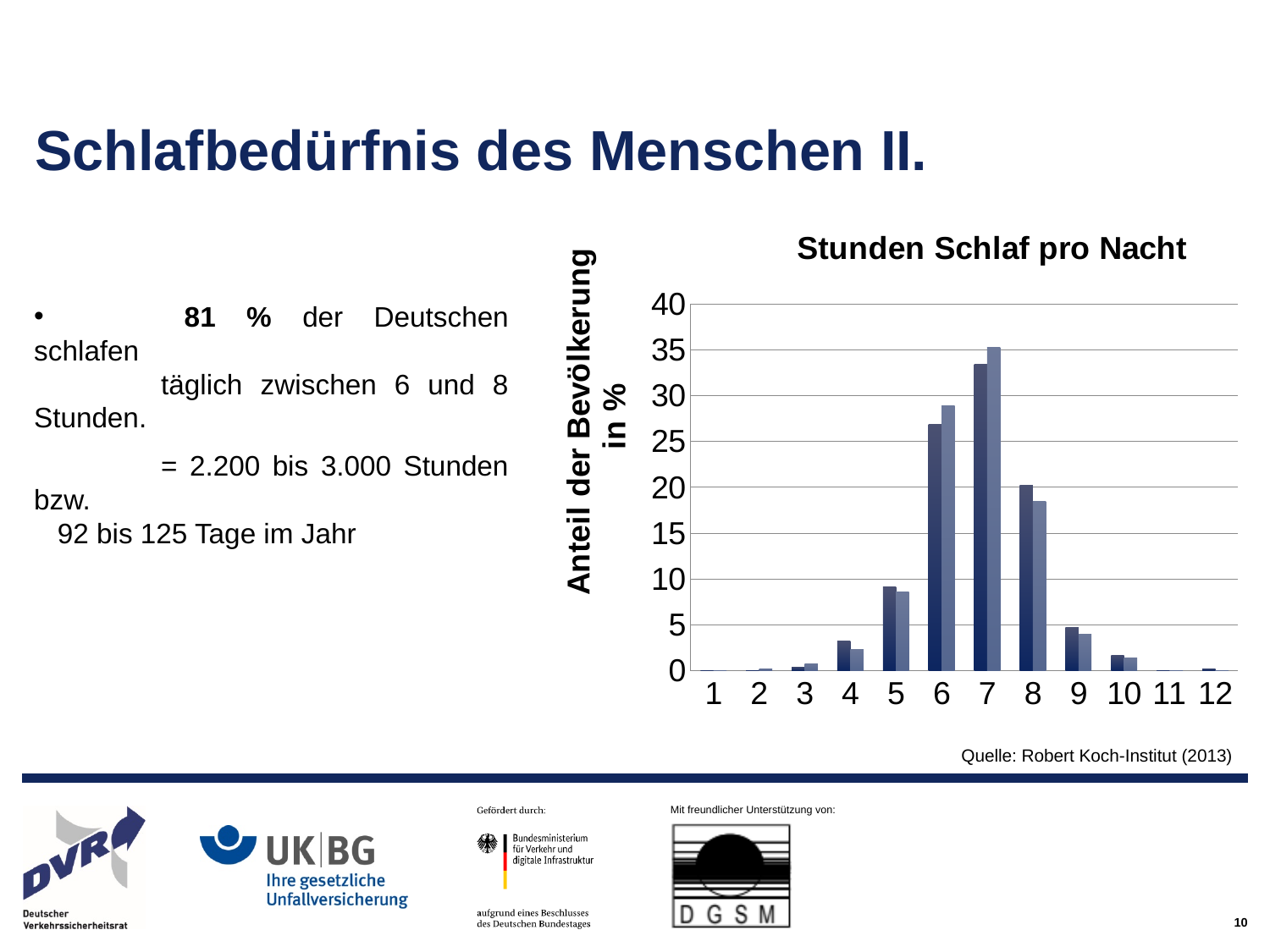
Do the bar values rise or fall along the x axis from category 7 to category 12? fall What is the title of the chart? Stunden Schlaf pro Nacht What is the label of the vertical axis of the chart? Anteil der Bevölkerung in % Is the value of the dark blue bar for category 5 greater or less than 10? less Is the value of the dark blue bar for category 4 greater or less than 5? less Which has the larger dark blue bar, category 6 or category 8? 6 Is the value of the dark blue bar for category 7 greater or less than 30? greater What kind of chart is shown on the slide? bar chart Which category on the x axis has the highest bars in the chart? 7 How many categories are shown on the x axis of the chart? 12